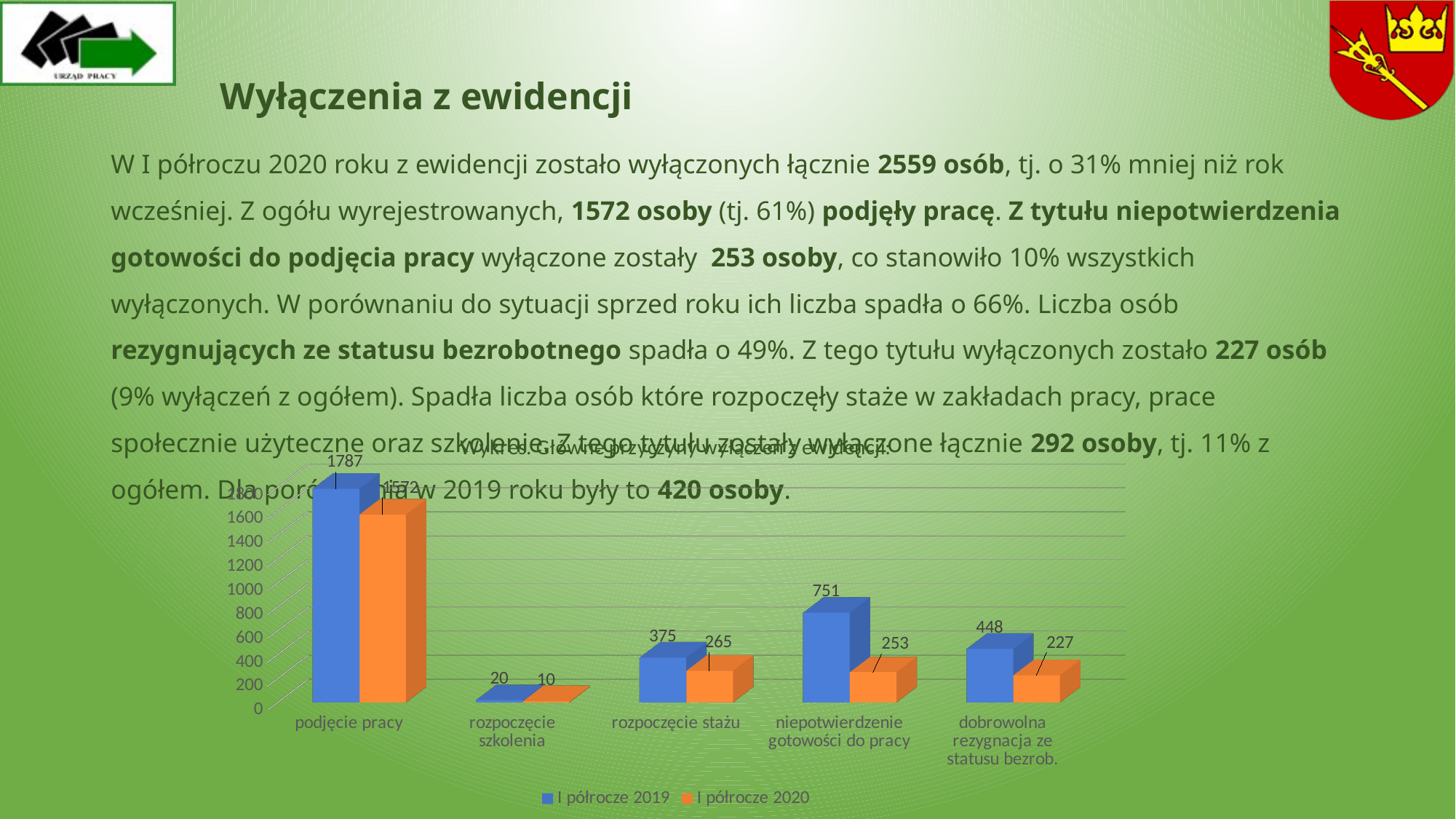
Which category has the highest value in the I półrocze 2019 series? podjęcie pracy What is the value for niepotwierdzenie gotowości do pracy in the I półrocze 2020 series? 253 How many categories are shown on the x axis of the chart? 5 What is the difference between the I półrocze 2019 and I półrocze 2020 values for niepotwierdzenie gotowości do pracy? 498 What is the value for podjęcie pracy in the I półrocze 2019 series? 1787 Which is larger for rozpoczęcie stażu: the I półrocze 2019 value or the I półrocze 2020 value? I półrocze 2019 What is the value for rozpoczęcie stażu in the I półrocze 2019 series? 375 What is the value for dobrowolna rezygnacja ze statusu bezrob. in the I półrocze 2020 series? 227 Which colour represents the I półrocze 2020 series in the chart? orange How many series does the chart legend list? 2 Which category has the lowest value in the I półrocze 2020 series? rozpoczęcie szkolenia What kind of chart is shown on the slide? bar chart